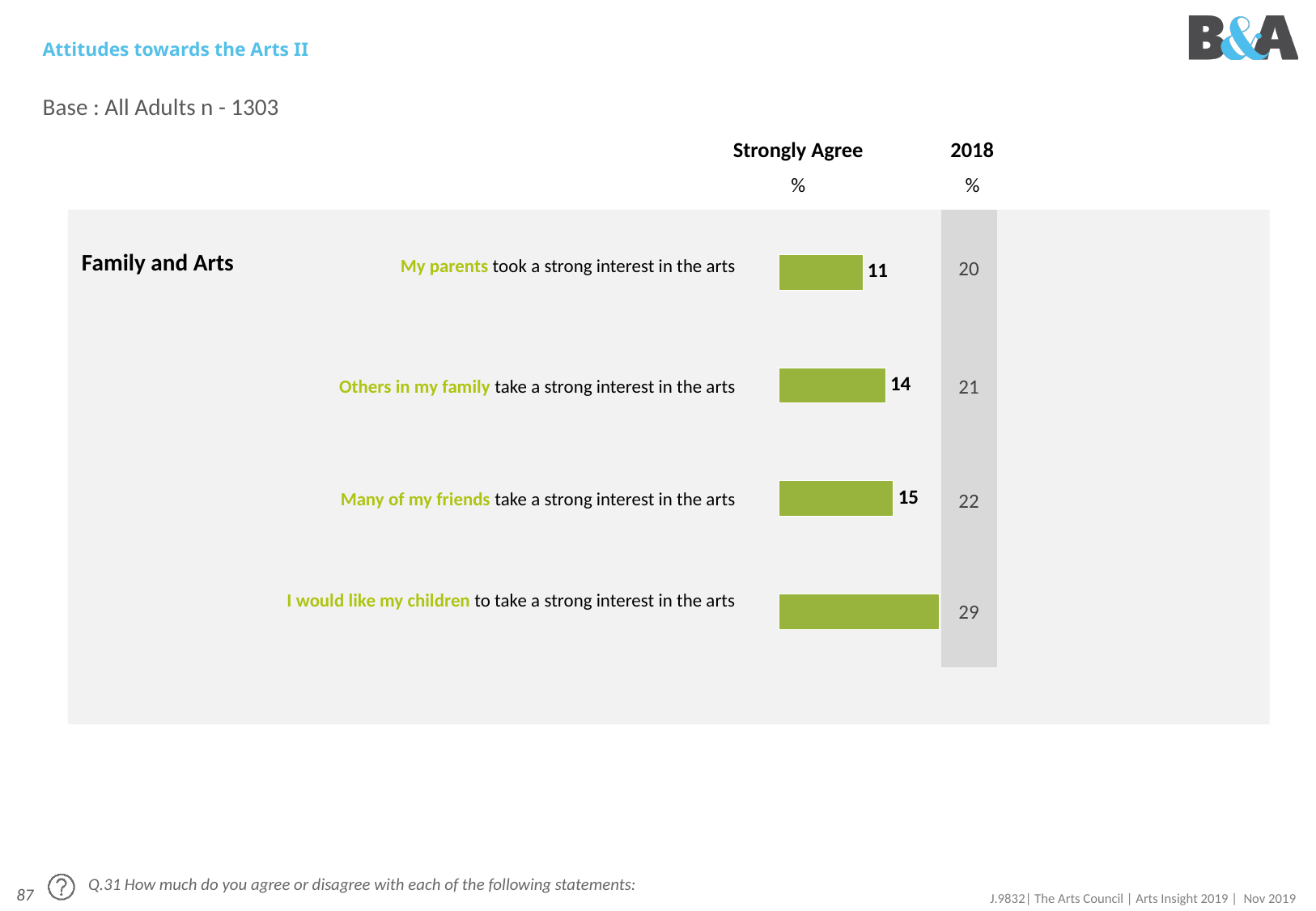
What colour are the bars in the chart? Green What is the Strongly Agree value for 'Others in my family take a strong interest in the arts'? 14 Which has a larger Strongly Agree value: 'Others in my family take a strong interest in the arts' or 'Many of my friends take a strong interest in the arts'? Many of my friends take a strong interest in the arts How much higher is the Strongly Agree value for 'Others in my family take a strong interest in the arts' than for 'My parents took a strong interest in the arts'? 3 What is the Strongly Agree value for 'Many of my friends take a strong interest in the arts'? 15 What percentage strongly agree that 'My parents took a strong interest in the arts'? 11 How many statements are shown in the chart? 4 What is the difference in Strongly Agree percentage between 'Many of my friends take a strong interest in the arts' and 'My parents took a strong interest in the arts'? 4 Which statement has the lowest Strongly Agree bar? My parents took a strong interest in the arts Which statement has the highest Strongly Agree bar? I would like my children to take a strong interest in the arts What was the 2018 value shown for 'My parents took a strong interest in the arts'? 20 What kind of chart is shown on the slide? Bar chart